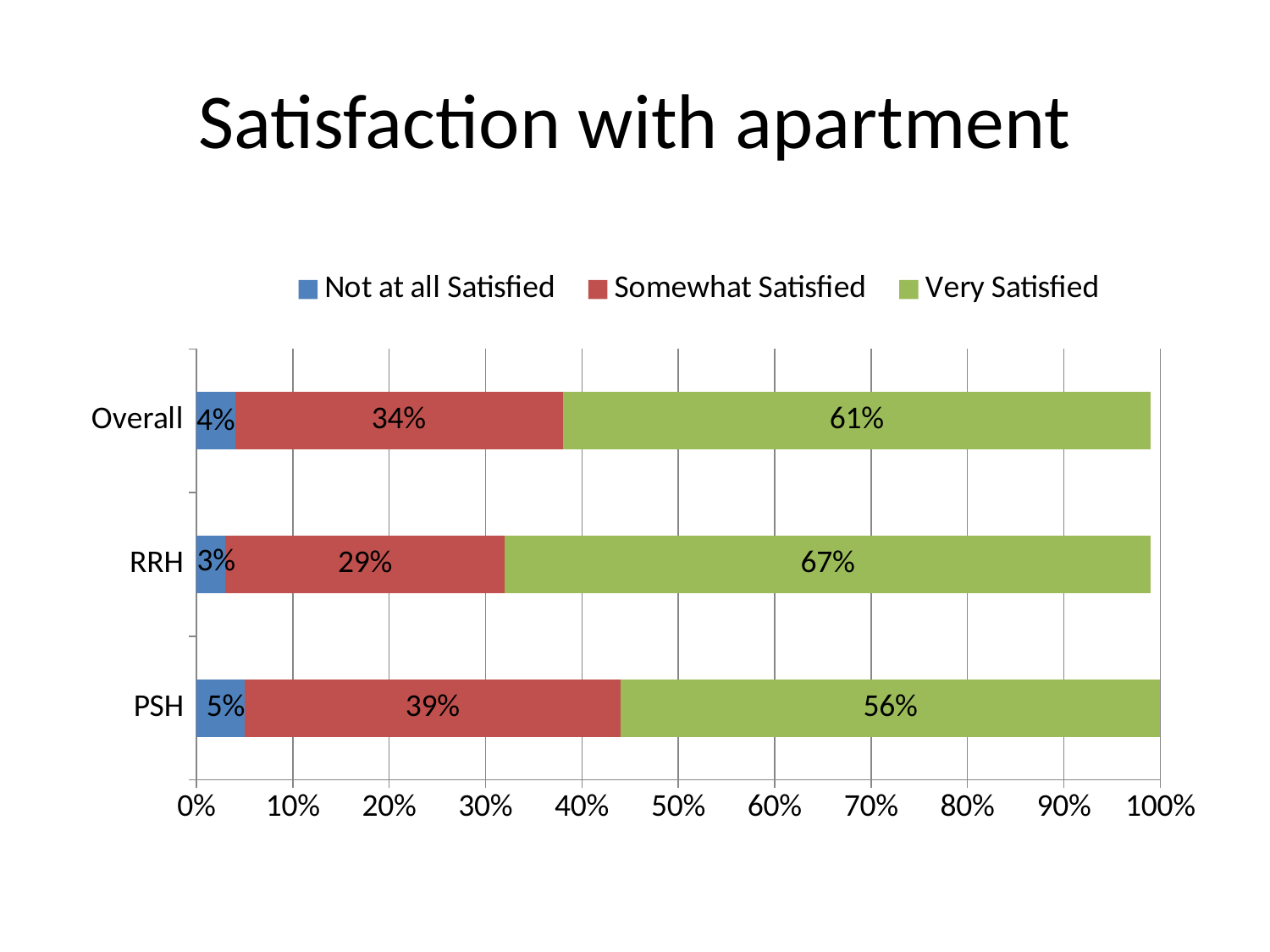
What kind of chart is shown on the slide? Stacked bar chart What is the Very Satisfied value for RRH? 67% Which category has the highest Very Satisfied value? RRH What is the Not at all Satisfied value for Overall? 4% Which is larger, the Very Satisfied value for Overall or for PSH? Overall What is the title of the chart? Satisfaction with apartment What is the difference between the Somewhat Satisfied values for PSH and RRH? 10% Which colour represents the Very Satisfied series? Green How many series does the legend list? 3 Which category has the lowest Not at all Satisfied value? RRH How many categories are shown on the y axis? 3 What is the Somewhat Satisfied value for PSH? 39%